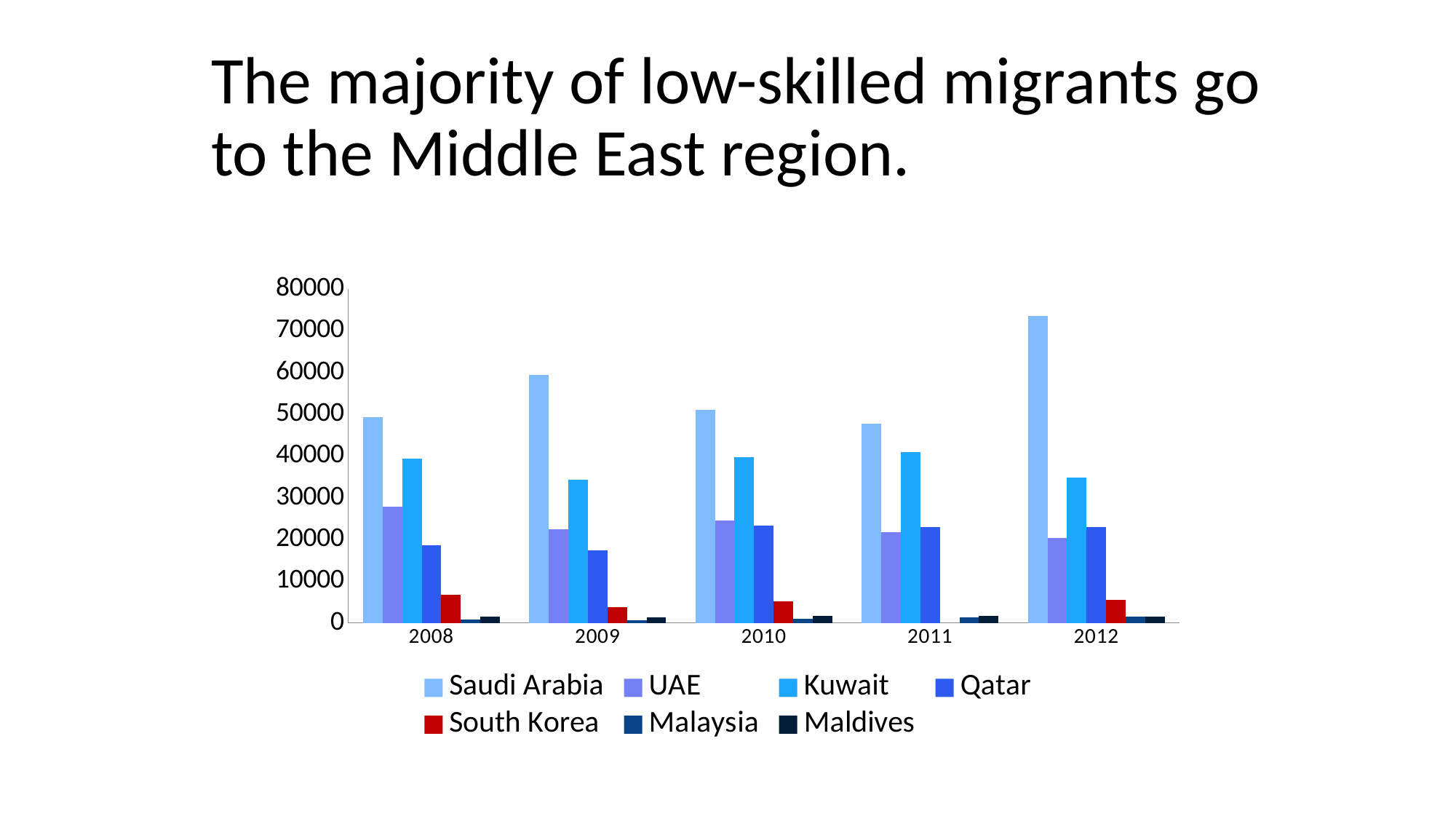
In which year is the Saudi Arabia bar the highest? 2012 Is the value for Saudi Arabia in 2009 greater or less than 50000? greater What colour represents South Korea in the legend? Red How many series does the legend list? 7 What kind of chart is shown on the slide? Bar chart Which series has the highest bar in 2010? Saudi Arabia Does the Saudi Arabia value rise or fall from 2011 to 2012? rise In 2008, which is larger: Kuwait or UAE? Kuwait Is the value for UAE in 2008 greater or less than 30000? less How many years are shown on the x axis? 5 Is the value for Kuwait in 2009 greater or less than 30000? greater